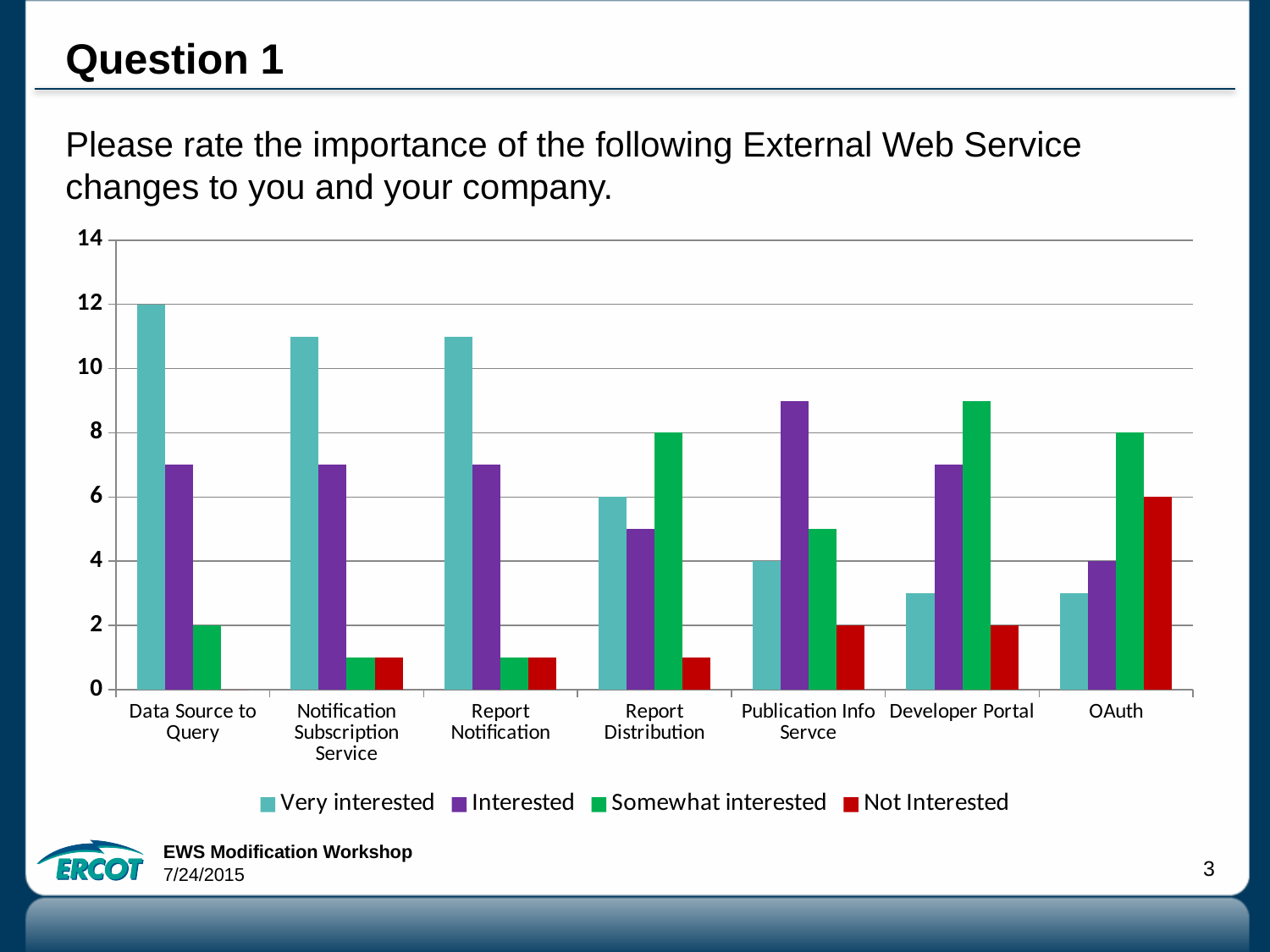
What kind of chart is shown on the slide? bar chart What is the value for Very interested for Data Source to Query? 12 What is the value for Not Interested for OAuth? 6 Is the value for Very interested for Developer Portal greater or less than 4? less What is the value for Somewhat interested for Report Distribution? 8 How many series does the legend list? 4 Which category has the highest Not Interested value? OAuth Which category has the highest Very interested value? Data Source to Query How many categories are shown on the x axis? 7 Is the value for Interested for Publication Info Servce greater or less than 8? greater What is the difference between the Very interested values for Data Source to Query and Report Distribution? 6 Which is larger for OAuth: Somewhat interested or Interested? Somewhat interested